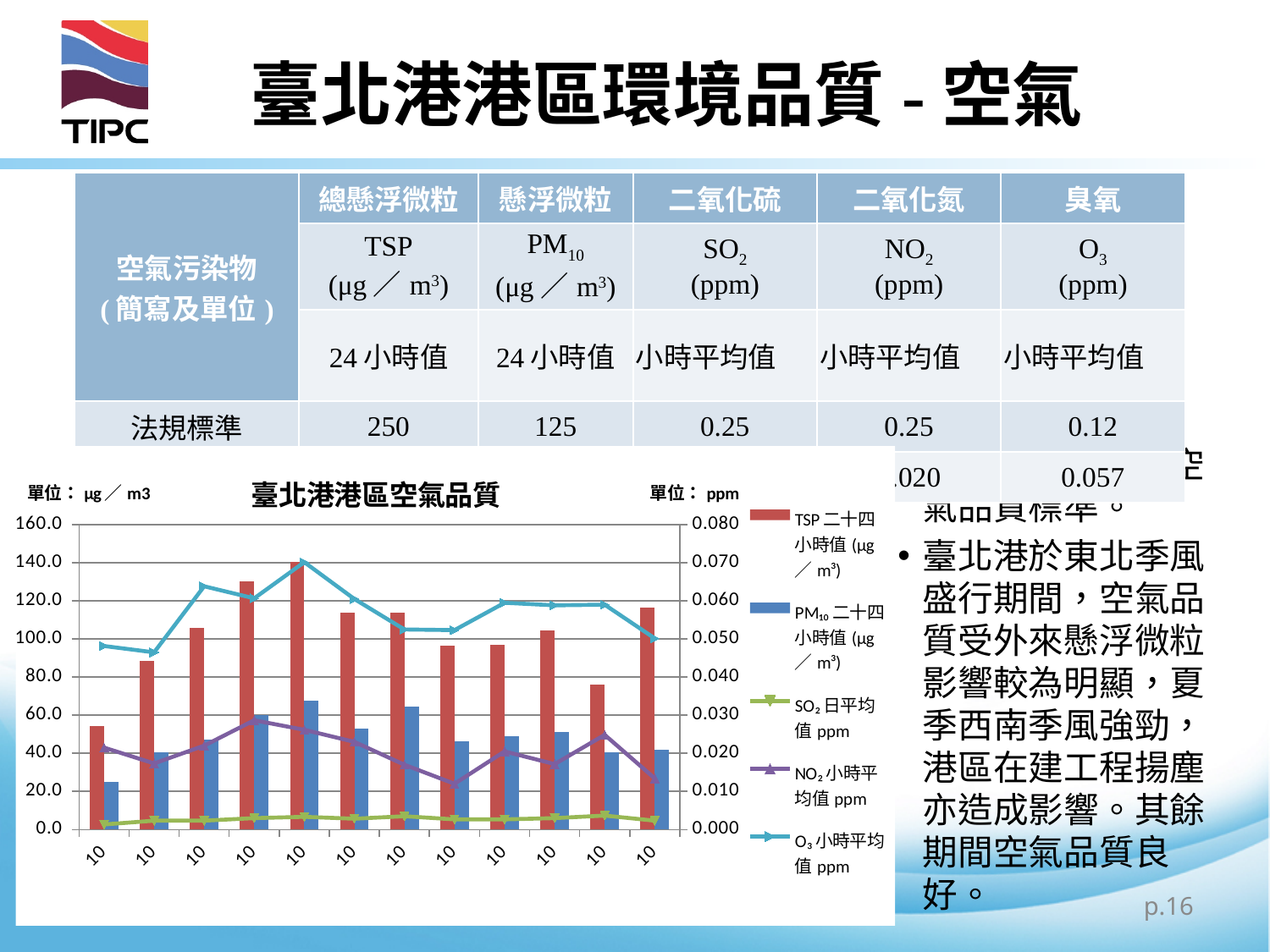
What kind of chart is shown on the slide? A combined bar and line chart Is the value of the leftmost PM10 bar greater or less than 40? less How many series does the chart's legend list? 5 Which line series stays closest to 0.000 on the right axis throughout the chart? SO₂ 日平均值 Is the highest point of the O₃ line greater or less than 0.060 ppm? greater What unit is shown for the left vertical axis of the chart? μg／m3 What is the title of the chart on the slide? 臺北港港區空氣品質 How many TSP bars are plotted in the chart? 12 Is the value of the leftmost TSP bar greater or less than 40? greater Which series has the taller bars throughout the chart, TSP or PM10? TSP Which line series has the highest values on the right axis throughout the chart? O₃ 小時平均值